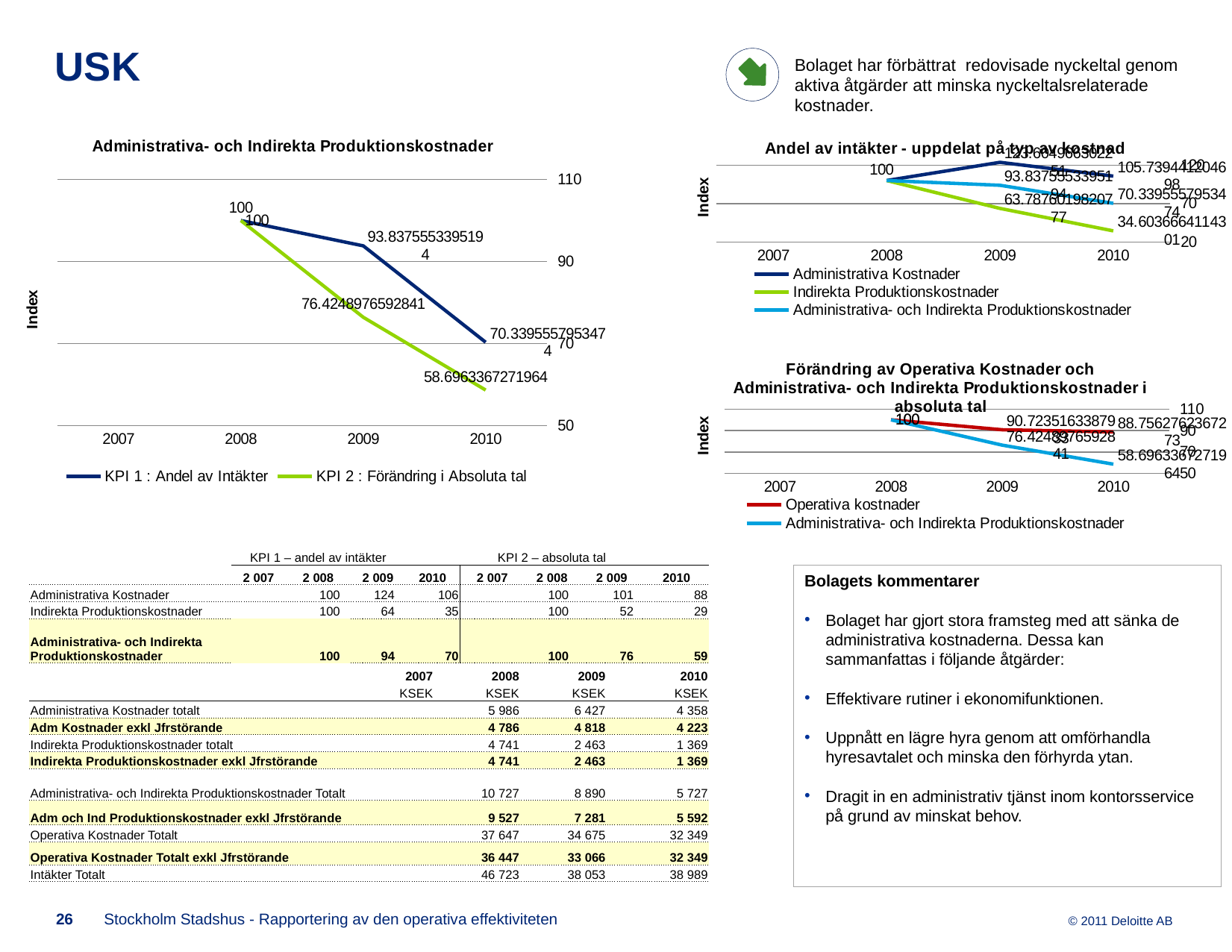
In the chart titled 'Administrativa- och Indirekta Produktionskostnader', how many years are labelled on the x axis? 4 In the chart titled 'Administrativa- och Indirekta Produktionskostnader', is the value for KPI 1 : Andel av Intäkter in 2009 greater or less than 90? greater In the chart titled 'Administrativa- och Indirekta Produktionskostnader', does KPI 2 : Förändring i Absoluta tal rise or fall from 2008 to 2010? fall In the chart titled 'Administrativa- och Indirekta Produktionskostnader', which series has the larger value in 2010, KPI 1 : Andel av Intäkter or KPI 2 : Förändring i Absoluta tal? KPI 1 : Andel av Intäkter What kind of chart is the chart titled 'Administrativa- och Indirekta Produktionskostnader'? line chart In the chart titled 'Administrativa- och Indirekta Produktionskostnader', what is the value of KPI 1 : Andel av Intäkter in 2008? 100 In the chart titled 'Administrativa- och Indirekta Produktionskostnader', how many series does the legend list? 2 In the chart titled 'Förändring av Operativa Kostnader och Administrativa- och Indirekta Produktionskostnader i absoluta tal', how many series does the legend list? 2 In the chart titled 'Andel av intäkter - uppdelat på typ av kostnad', how many series does the legend list? 3 In the chart titled 'Administrativa- och Indirekta Produktionskostnader', is the value for KPI 2 : Förändring i Absoluta tal in 2010 greater or less than 70? less In the chart titled 'Förändring av Operativa Kostnader och Administrativa- och Indirekta Produktionskostnader i absoluta tal', which series has the larger value in 2010, Operativa kostnader or Administrativa- och Indirekta Produktionskostnader? Operativa kostnader In the chart titled 'Förändring av Operativa Kostnader och Administrativa- och Indirekta Produktionskostnader i absoluta tal', what colour is the line for Operativa kostnader? red